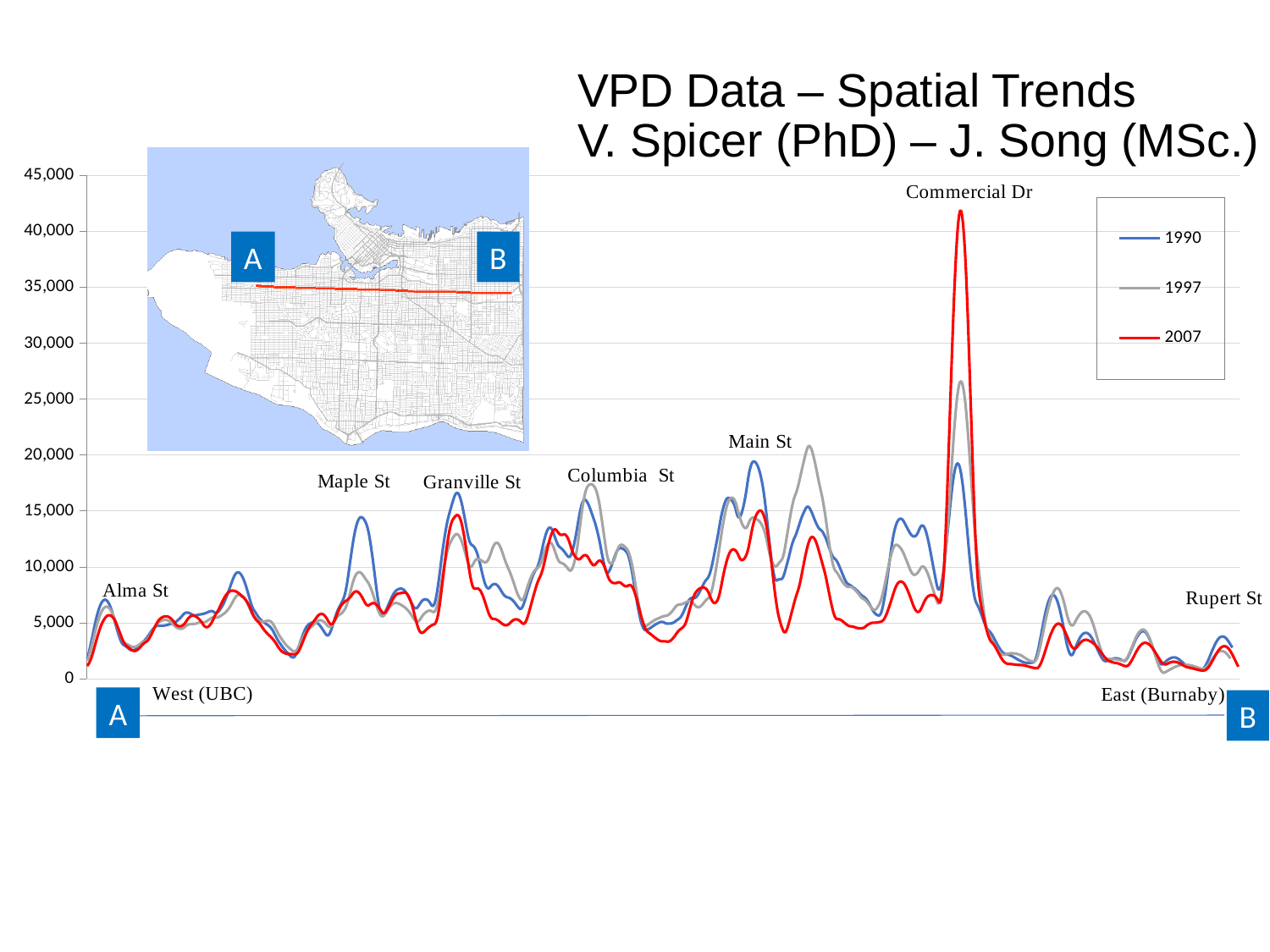
Which series has the lowest peak at Main St? 2007 What kind of chart is shown on the slide? line chart Which years are listed in the legend? 1990, 1997, 2007 Is the 1997 peak at Commercial Dr greater or less than 20,000? greater What is the highest value shown on the y axis? 45,000 Is the 1990 peak at Commercial Dr greater or less than 25,000? less Is the 2007 peak at Commercial Dr greater or less than 40,000? greater Which series peaks highest at Maple St? 1990 Which series reaches the highest peak at Commercial Dr? 2007 How many series does the legend list? 3 Which series has the lowest peak at Commercial Dr? 1990